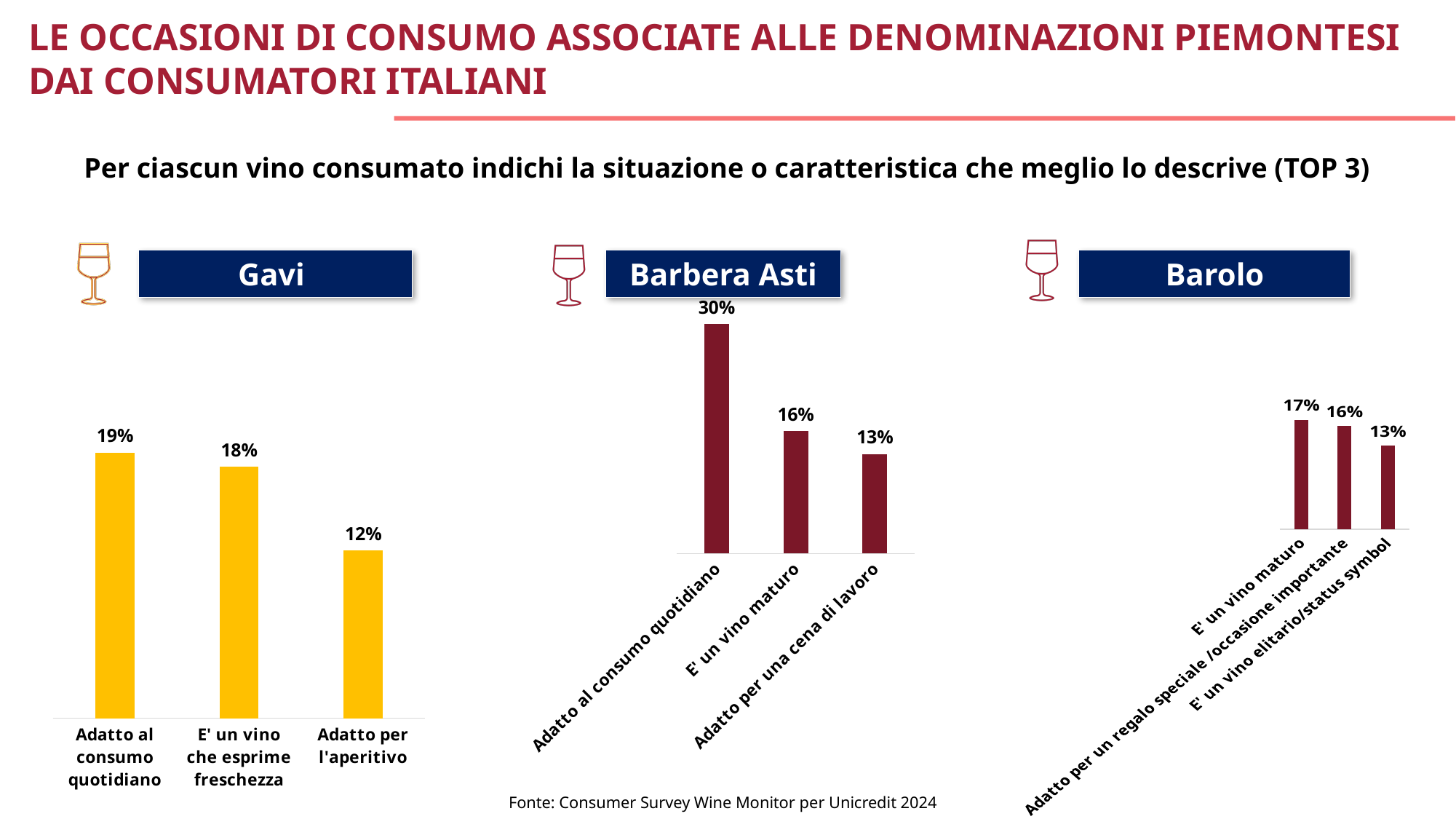
In the Barbera Asti chart, which category has the highest value? Adatto al consumo quotidiano In the Barolo chart, what is the value for "E' un vino elitario/status symbol"? 13% In the Barolo chart, what is the difference between "E' un vino maturo" and "E' un vino elitario/status symbol"? 4% What kind of chart is the Gavi chart? Bar chart In the Gavi chart, which category has the lowest value? Adatto per l'aperitivo In the Barbera Asti chart, what is the value for "Adatto al consumo quotidiano"? 30% Which is larger: "E' un vino maturo" in the Barbera Asti chart or "E' un vino maturo" in the Barolo chart? Barolo In the Barbera Asti chart, what is the difference between "Adatto al consumo quotidiano" and "Adatto per una cena di lavoro"? 17% How many categories are shown in the Barolo chart? 3 In the Gavi chart, what is the value for "Adatto al consumo quotidiano"? 19% In the Gavi chart, what is the value for "Adatto per l'aperitivo"? 12% What colour are the bars in the Gavi chart? Yellow